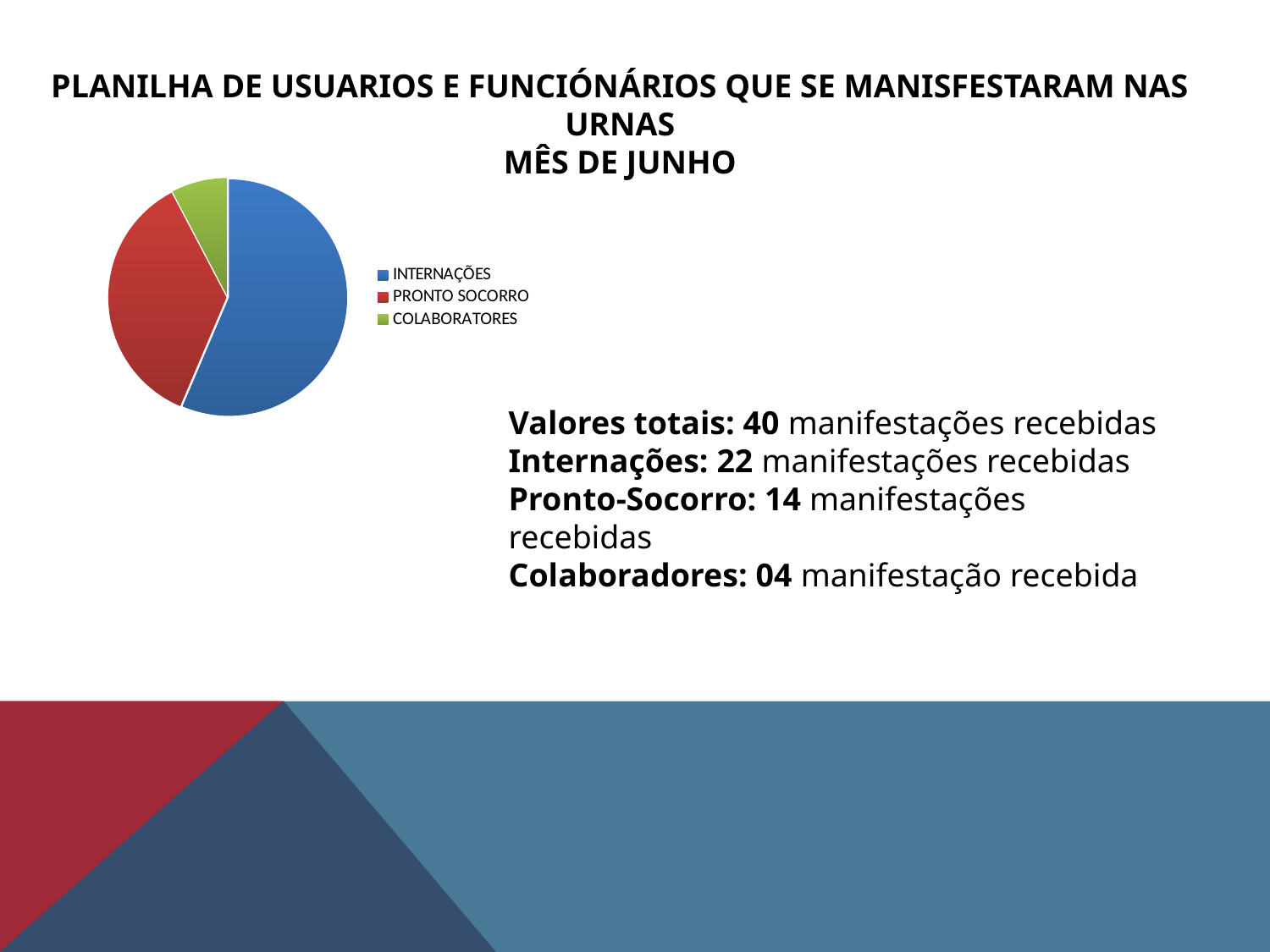
What is the difference between the Internações and Pronto-Socorro values shown on the slide? 8 According to the slide, how many manifestações were received for Colaboradores? 04 What kind of chart is shown on the slide? pie chart According to the slide, how many manifestações were received for Internações? 22 According to the slide, how many manifestações were received for Pronto-Socorro? 14 What colour is the INTERNAÇÕES slice in the pie chart? blue Which slice is larger in the pie chart, PRONTO SOCORRO or COLABORATORES? PRONTO SOCORRO How many slices does the pie chart have? 3 How many entries does the legend of the pie chart list? 3 Which category has the largest slice of the pie chart? INTERNAÇÕES Which category has the smallest slice of the pie chart? COLABORATORES What is the total number of manifestações received according to the slide? 40